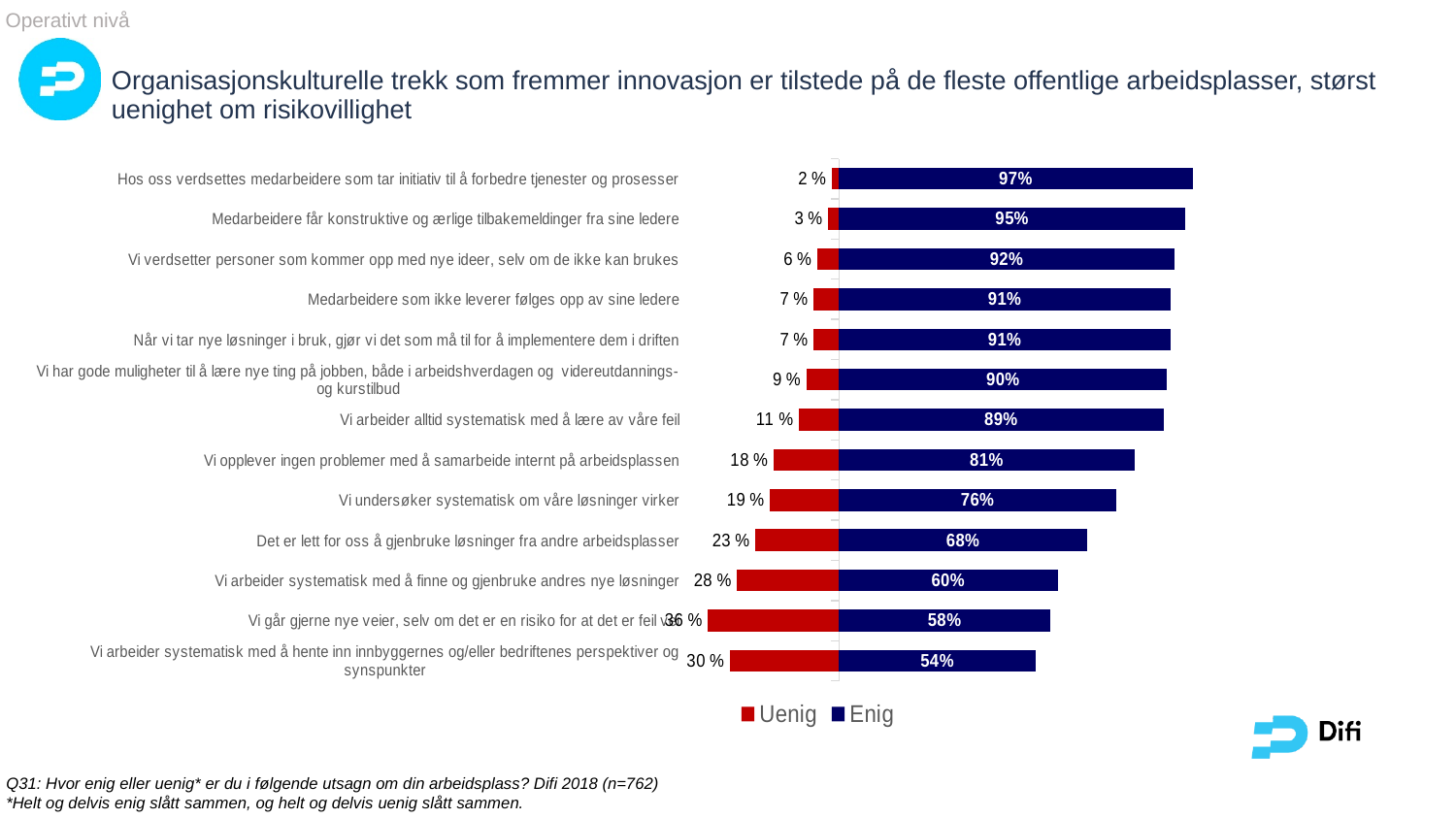
How many series does the legend list? 2 What are the two series named in the legend? Uenig and Enig Which statement has the lowest Enig value? Vi arbeider systematisk med å hente inn innbyggernes og/eller bedriftenes perspektiver og synspunkter Which statement has the highest Enig value? Hos oss verdsettes medarbeidere som tar initiativ til å forbedre tjenester og prosesser What is the difference between the Enig values for "Medarbeidere får konstruktive og ærlige tilbakemeldinger fra sine ledere" and "Det er lett for oss å gjenbruke løsninger fra andre arbeidsplasser"? 27 percentage points Which has a larger Uenig value: "Vi opplever ingen problemer med å samarbeide internt på arbeidsplassen" or "Vi arbeider alltid systematisk med å lære av våre feil"? Vi opplever ingen problemer med å samarbeide internt på arbeidsplassen What is the Enig value for "Vi arbeider systematisk med å finne og gjenbruke andres nye løsninger"? 60% What is the Enig value for "Hos oss verdsettes medarbeidere som tar initiativ til å forbedre tjenester og prosesser"? 97% What is the Uenig value for "Vi har gode muligheter til å lære nye ting på jobben, både i arbeidshverdagen og videreutdannings- og kurstilbud"? 9 % What kind of chart is shown on the slide? bar chart How many statements (categories) are plotted in the chart? 13 What is the Uenig value for "Vi undersøker systematisk om våre løsninger virker"? 19 %